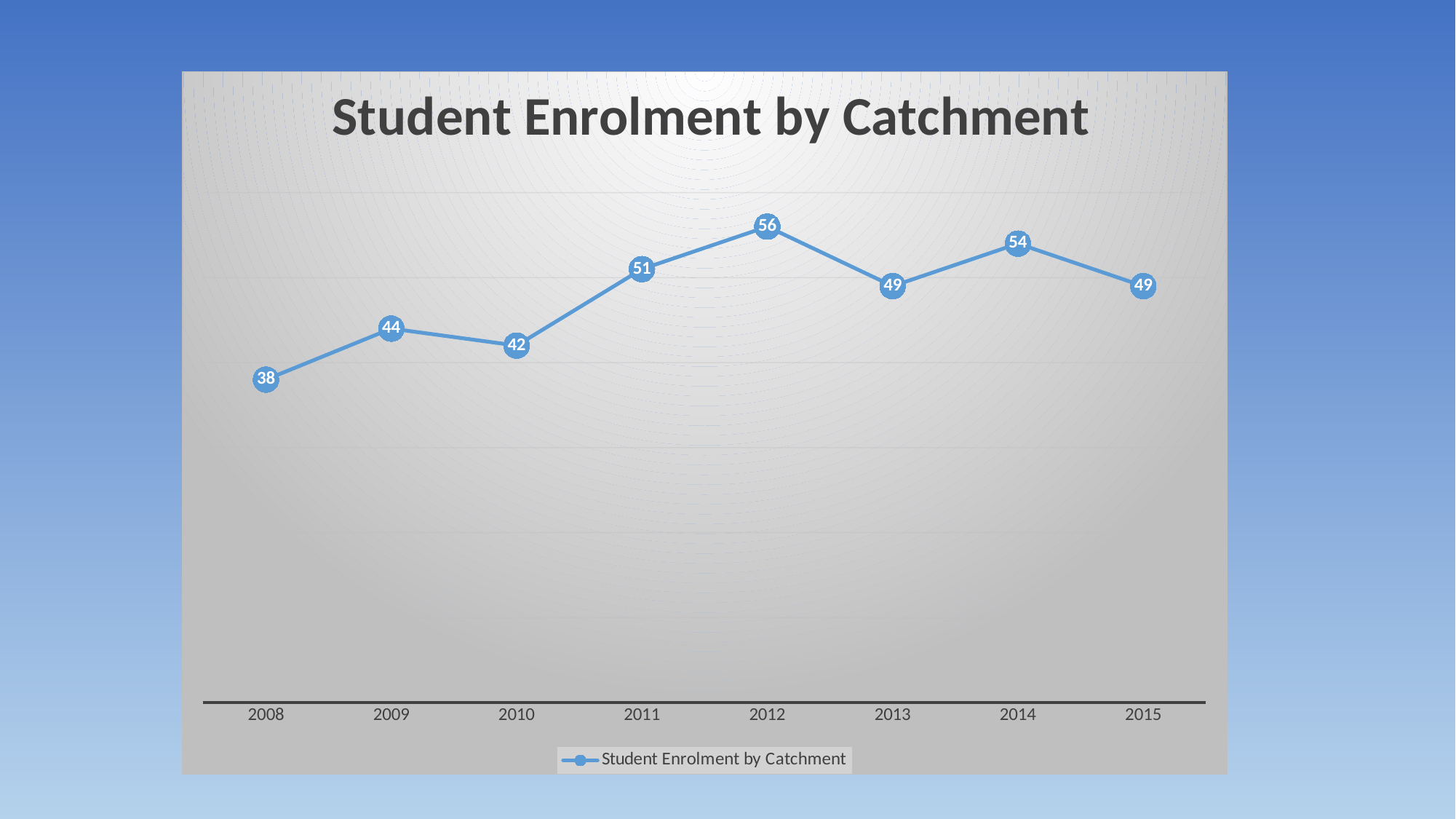
What is the student enrolment value for 2008? 38 How many series does the legend list? 1 What is the student enrolment value for 2012? 56 What is the difference between the enrolment in 2011 and the enrolment in 2010? 9 How many years are plotted on the chart? 8 Which year has a higher enrolment, 2009 or 2013? 2013 What kind of chart is shown on the slide? Line chart What is the student enrolment value for 2014? 54 What is the title of the chart? Student Enrolment by Catchment Which year has the highest student enrolment? 2012 What is the difference between the enrolment in 2012 and the enrolment in 2008? 18 Which year has the lowest student enrolment? 2008